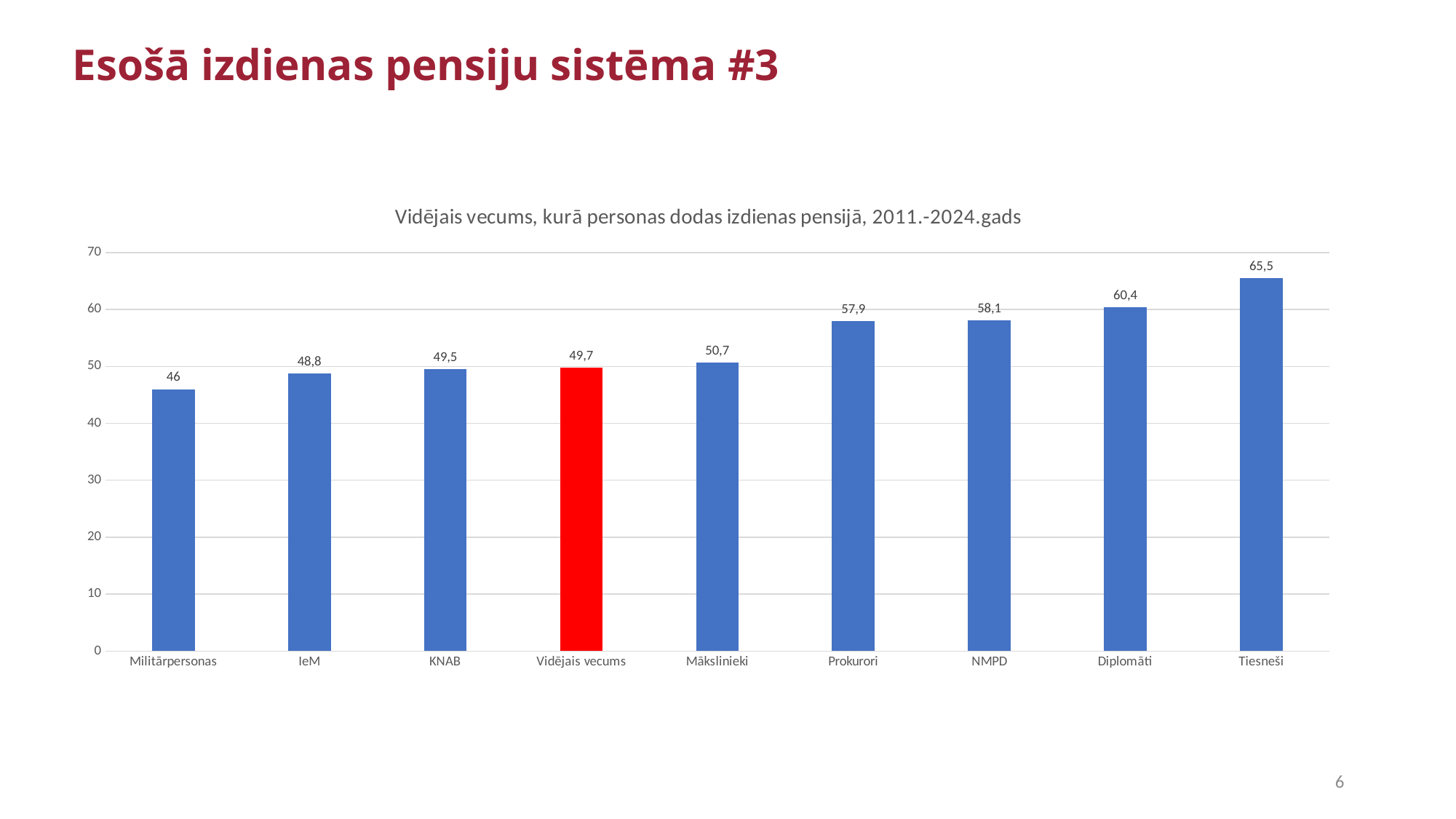
How many categories are shown on the x axis? 9 Which is larger, the value for Mākslinieki or the value for KNAB? Mākslinieki What is the value for Prokurori? 57,9 What kind of chart is shown on the slide? Bar chart Which bar is coloured red? Vidējais vecums What is the difference between the values for Tiesneši and Militārpersonas? 19,5 Which category has the highest value? Tiesneši What is the difference between the values for Diplomāti and NMPD? 2,3 What is the value for Tiesneši? 65,5 Which category has the lowest value? Militārpersonas What is the value for Vidējais vecums? 49,7 What is the value for Militārpersonas? 46